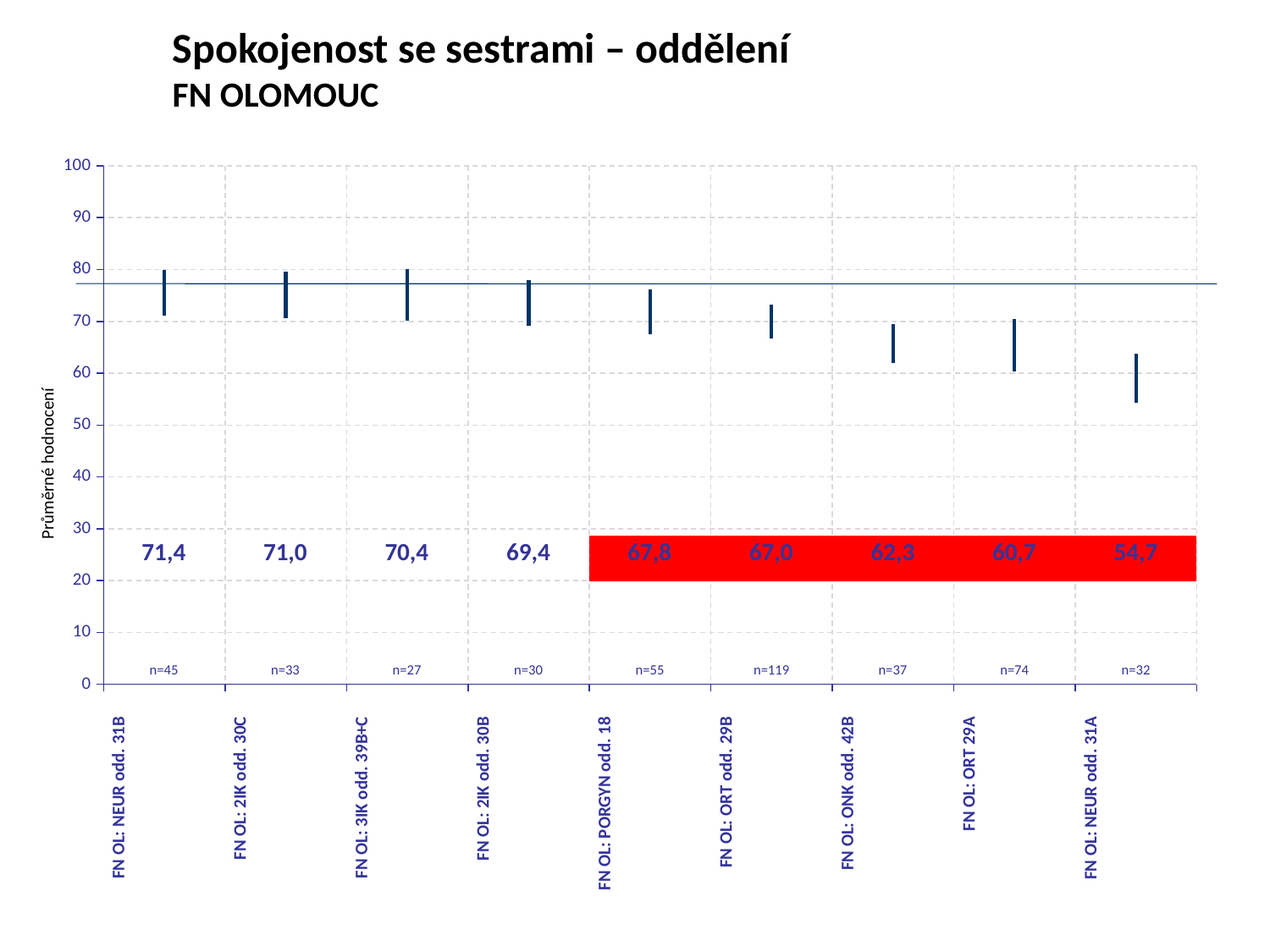
What is the value for FN OL: ONK odd. 42B? 62,3 What is the value for FN OL: NEUR odd. 31B? 71,4 Which department has the highest value? FN OL: NEUR odd. 31B What is the label of the vertical axis? Průměrné hodnocení Which department has the lowest value? FN OL: NEUR odd. 31A Do the values rise or fall from left to right along the x axis? fall What is the value for FN OL: PORGYN odd. 18? 67,8 Which is larger, the value for FN OL: 3IK odd. 39B+C or the value for FN OL: ORT odd. 29B? FN OL: 3IK odd. 39B+C How many departments are highlighted with a red band? 5 How many departments are shown on the chart? 9 What is the difference between the values for FN OL: 2IK odd. 30C and FN OL: ORT 29A? 10,3 What is the n value shown for FN OL: ORT odd. 29B? n=119